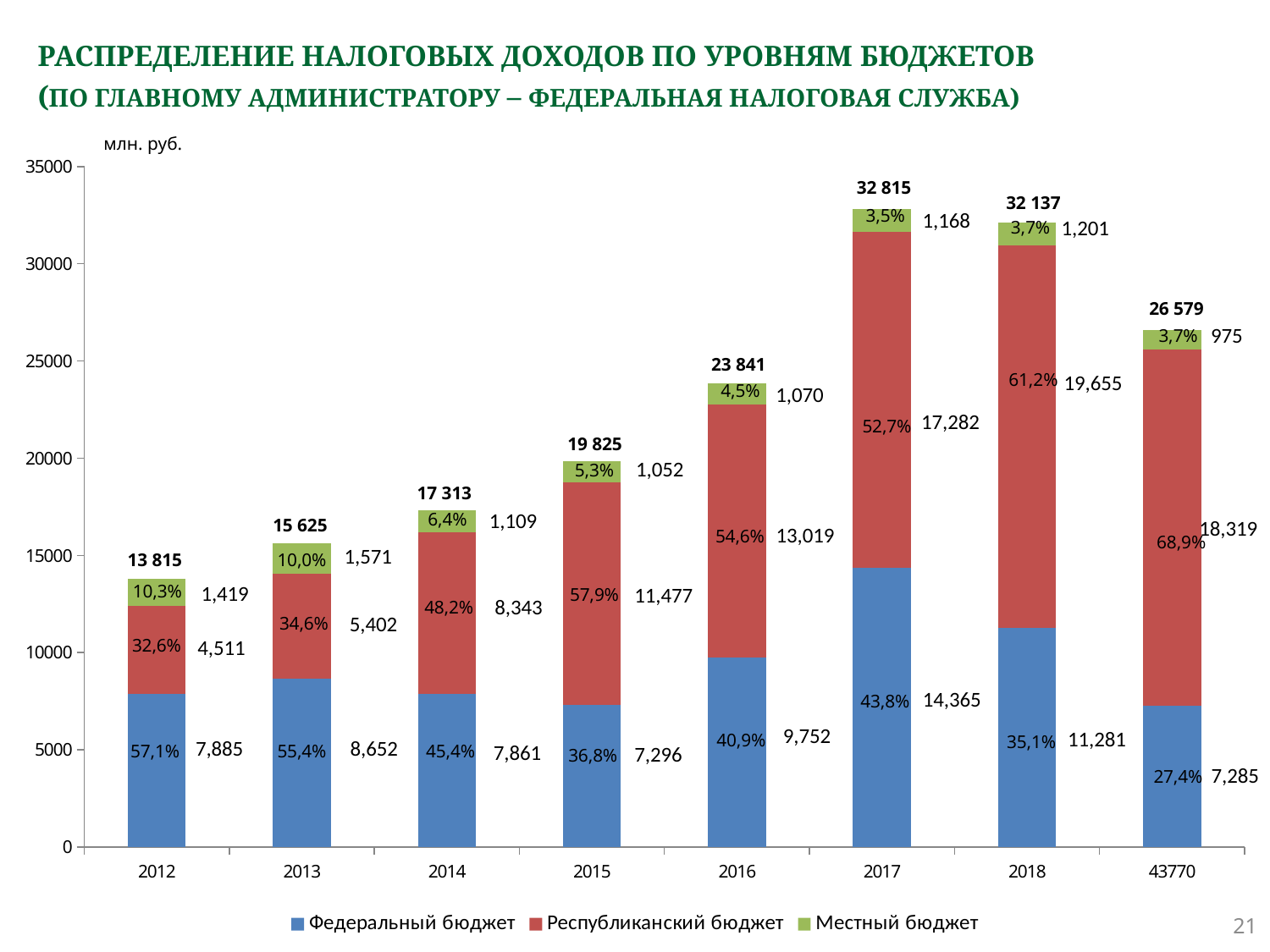
Which year has the lowest total stacked bar? 2012 What percentage share is labelled for Федеральный бюджет in 2015? 36,8% How many series does the legend list? 3 What is the total of the stacked bar for 2016? 23 841 What is the value of Местный бюджет for 2012? 1,419 What kind of chart is shown on the slide? stacked bar chart How many bars (categories) are plotted along the x axis? 8 What is the value of Республиканский бюджет for 2018? 19,655 Which year has the highest total stacked bar? 2017 By how much does Республиканский бюджет in 2018 exceed Республиканский бюджет in 2017? 2,373 What is the value of Федеральный бюджет for 2017? 14,365 Which year has the larger value for Федеральный бюджет, 2013 or 2014? 2013